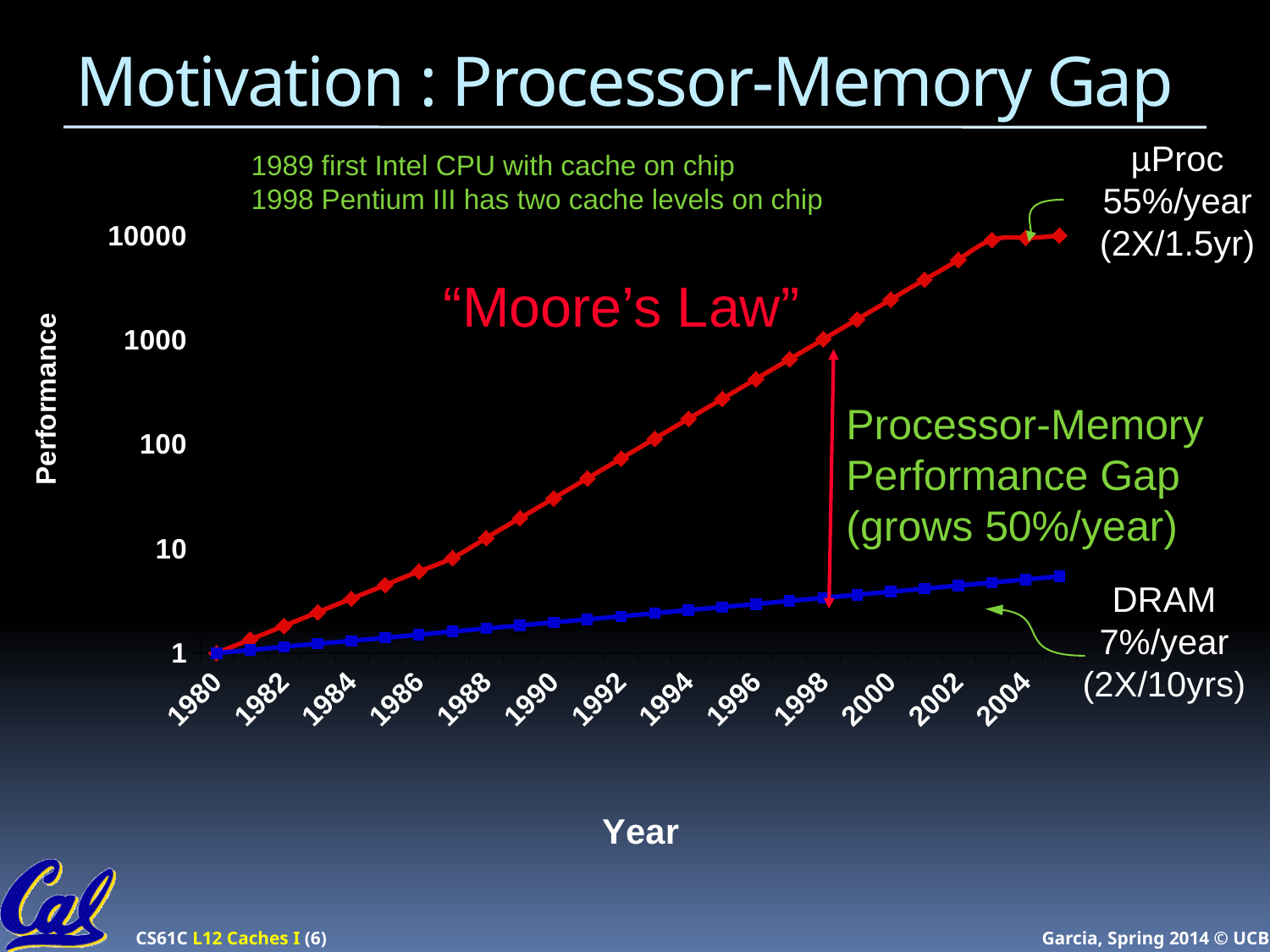
In 1998, is the µProc value larger or smaller than the DRAM value? larger Does the µProc line rise or fall as the year increases? rises Is the DRAM value for 1990 greater or less than 10? less What is the performance value of both series in 1980? 1 Is the DRAM value for 2004 greater or less than 10? less Which series reaches the higher performance value by 2004, µProc or DRAM? µProc Which series has the lower performance value in 1998, µProc or DRAM? DRAM Is the µProc value for 1998 greater or less than 100? greater How many data series (lines) are plotted on the chart? 2 How many year labels are shown on the x axis? 13 What kind of chart is shown on the slide? line chart